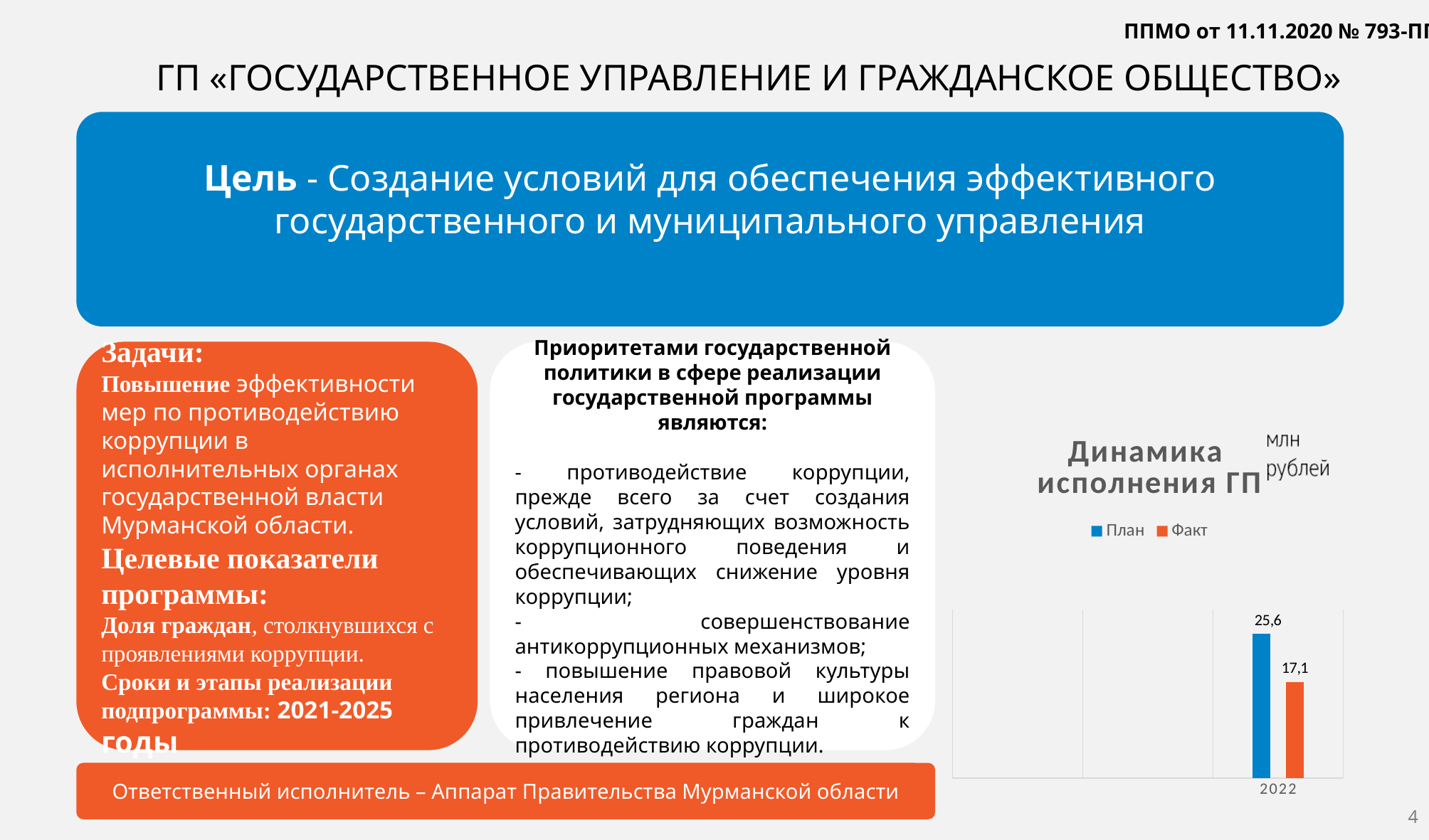
What kind of chart is "Динамика исполнения ГП"? Bar chart What is the value of План (plan) for 2022 in the chart "Динамика исполнения ГП"? 25,6 How many categories (years) are shown on the x axis of the chart "Динамика исполнения ГП"? 1 In the chart "Динамика исполнения ГП", what is the difference between План and Факт for 2022? 8,5 How many series does the legend of the chart "Динамика исполнения ГП" list? 2 What is the value of Факт (actual) for 2022 in the chart "Динамика исполнения ГП"? 17,1 Which year is shown on the x axis of the chart "Динамика исполнения ГП"? 2022 In the chart "Динамика исполнения ГП", which colour represents the Факт series? Orange What unit is indicated next to the title of the chart "Динамика исполнения ГП"? млн рублей In the chart "Динамика исполнения ГП", which is larger for 2022: План or Факт? План